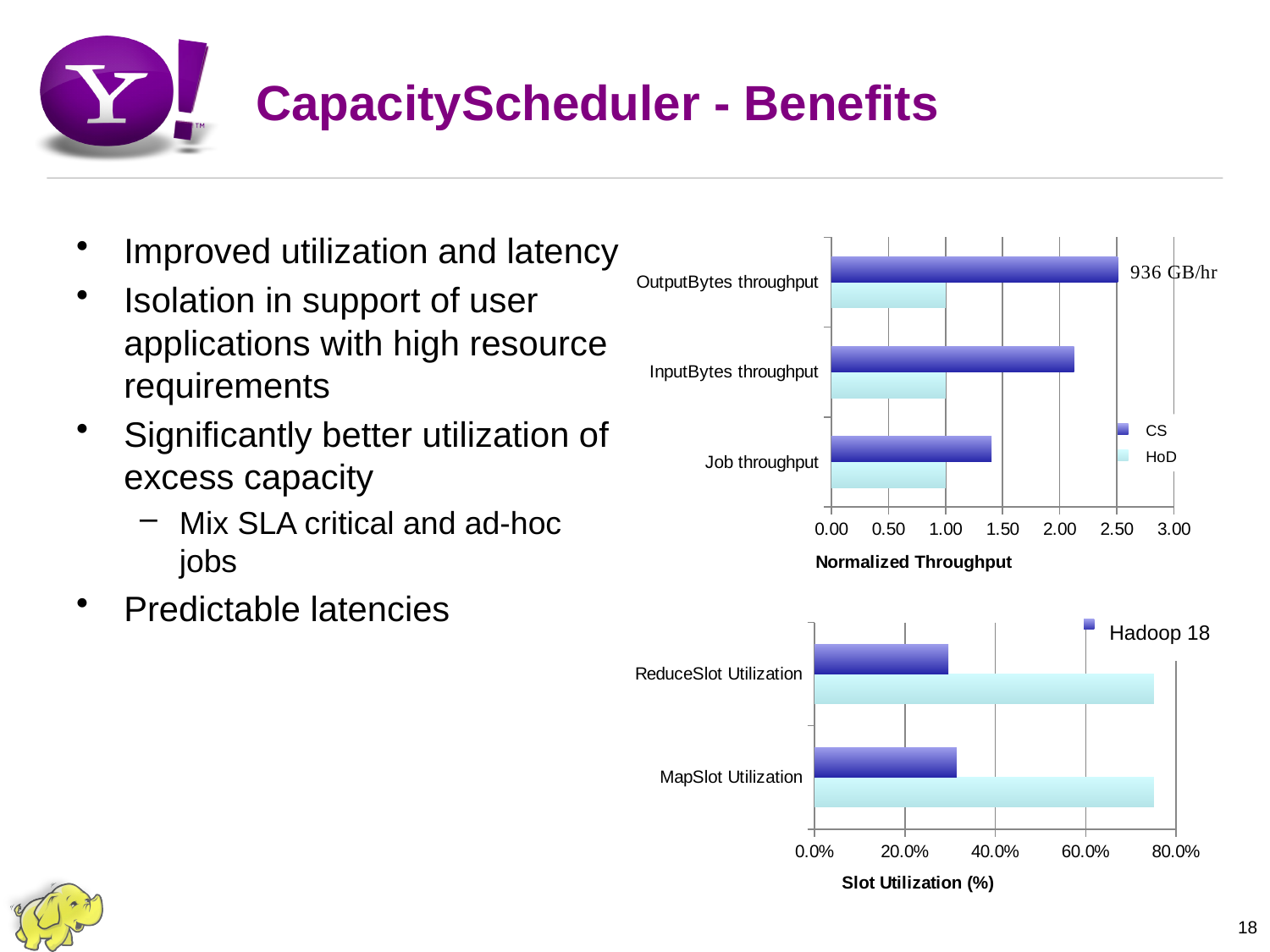
What kind of chart is the Normalized Throughput chart at the top right? bar chart In the Normalized Throughput chart, which category has the lowest CS value? Job throughput In the Slot Utilization (%) chart, is the light blue bar for ReduceSlot Utilization greater or less than 60.0%? greater In the Normalized Throughput chart, how many categories are shown on the vertical axis? 3 In the Normalized Throughput chart, is the CS value for Job throughput greater or less than 1.50? less In the Normalized Throughput chart, what annotation is printed next to the OutputBytes throughput CS bar? 936 GB/hr In the Slot Utilization (%) chart at the bottom right, how many categories are shown? 2 In the Normalized Throughput chart, which category has the highest CS value? OutputBytes throughput In the Normalized Throughput chart, which series has the larger value for InputBytes throughput, CS or HoD? CS In the Normalized Throughput chart, is the CS value for OutputBytes throughput greater or less than 2.00? greater In the Normalized Throughput chart, how many series does the legend list? 2